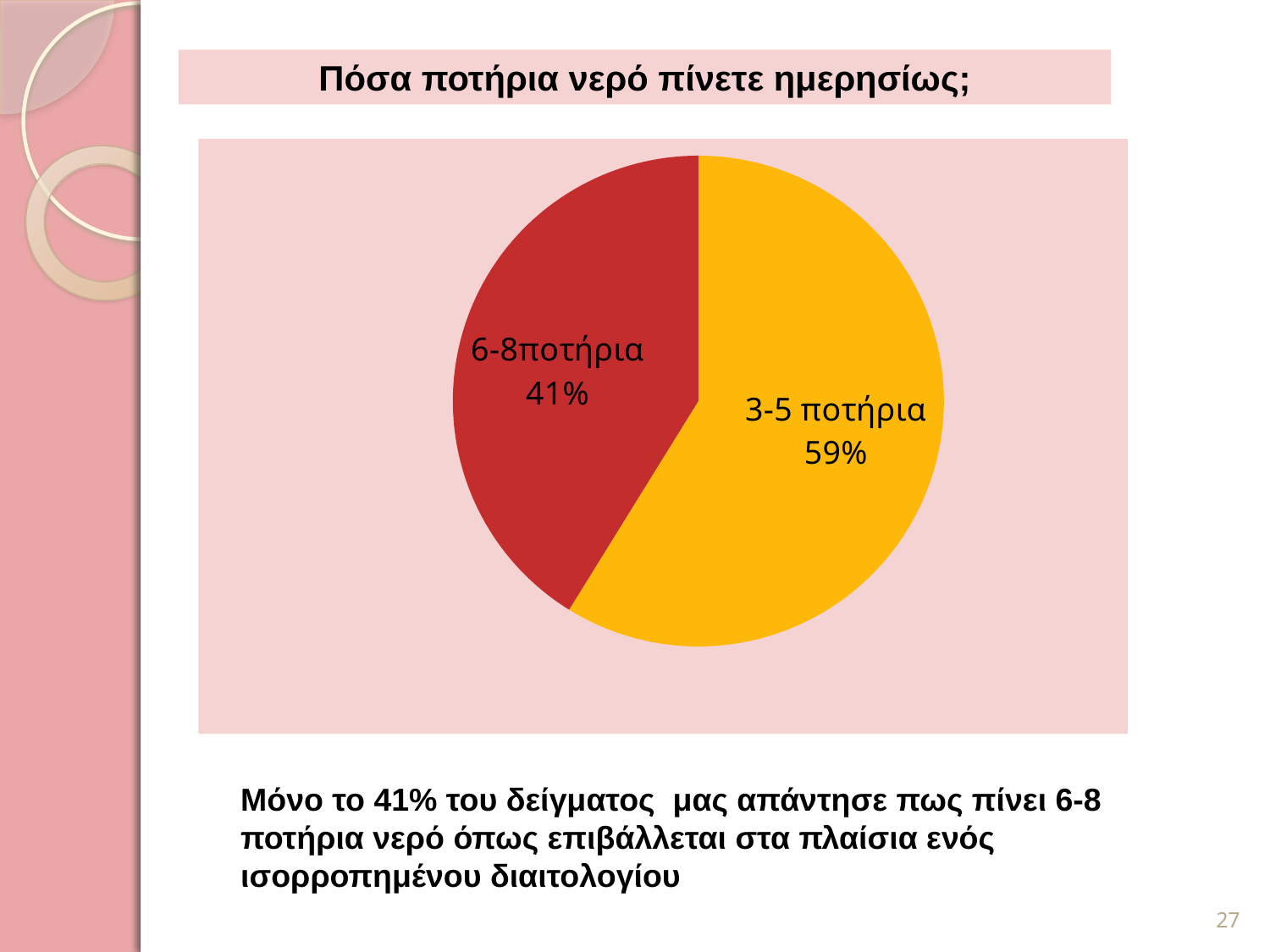
Which slice of the pie is the smallest? 6-8ποτήρια Is the share for '6-8ποτήρια' greater or less than 50%? less What share of the pie does the '6-8ποτήρια' slice represent? 41% What is the title of the chart on the slide? Πόσα ποτήρια νερό πίνετε ημερησίως; What is the difference in percentage points between the '3-5 ποτήρια' and '6-8ποτήρια' slices? 18 What kind of chart is shown on the slide? pie chart What colour is the '3-5 ποτήρια' slice? yellow Which is larger, the '3-5 ποτήρια' slice or the '6-8ποτήρια' slice? 3-5 ποτήρια Which slice of the pie is the largest? 3-5 ποτήρια What share of the pie does the '3-5 ποτήρια' slice represent? 59% How many slices does the pie chart have? 2